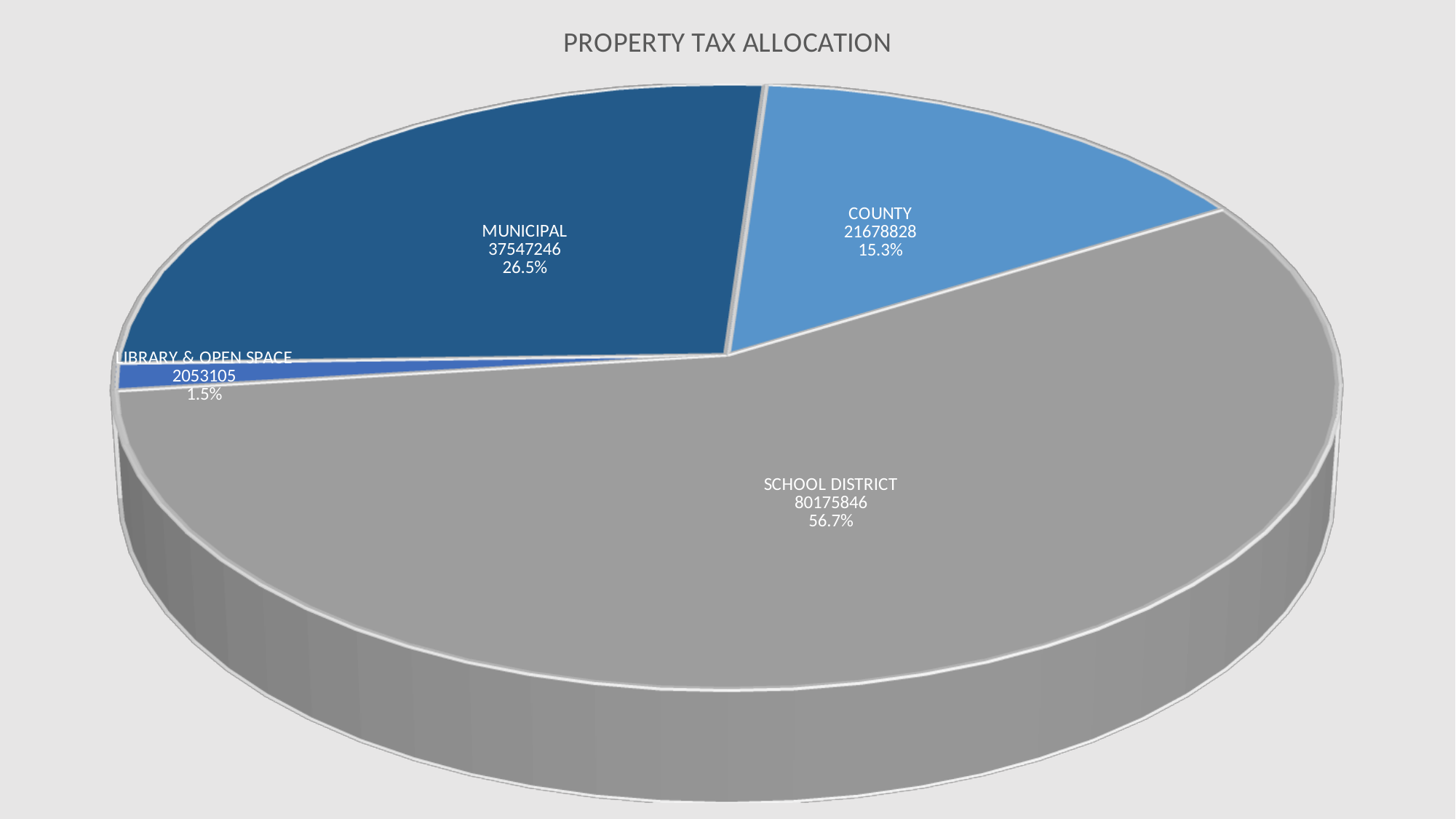
How many categories are shown in the pie chart? 4 What is the value for SCHOOL DISTRICT? 80175846 What share of the pie does COUNTY represent? 15.3% What is the difference between the values for MUNICIPAL and COUNTY? 15868418 What is the value for MUNICIPAL? 37547246 What is the value for COUNTY? 21678828 What is the value for LIBRARY & OPEN SPACE? 2053105 Which category has the largest slice? SCHOOL DISTRICT Which category has the smallest slice? LIBRARY & OPEN SPACE Which is larger, the value for COUNTY or the value for MUNICIPAL? MUNICIPAL What type of chart is shown on the slide? Pie chart What share of the pie does MUNICIPAL represent? 26.5%